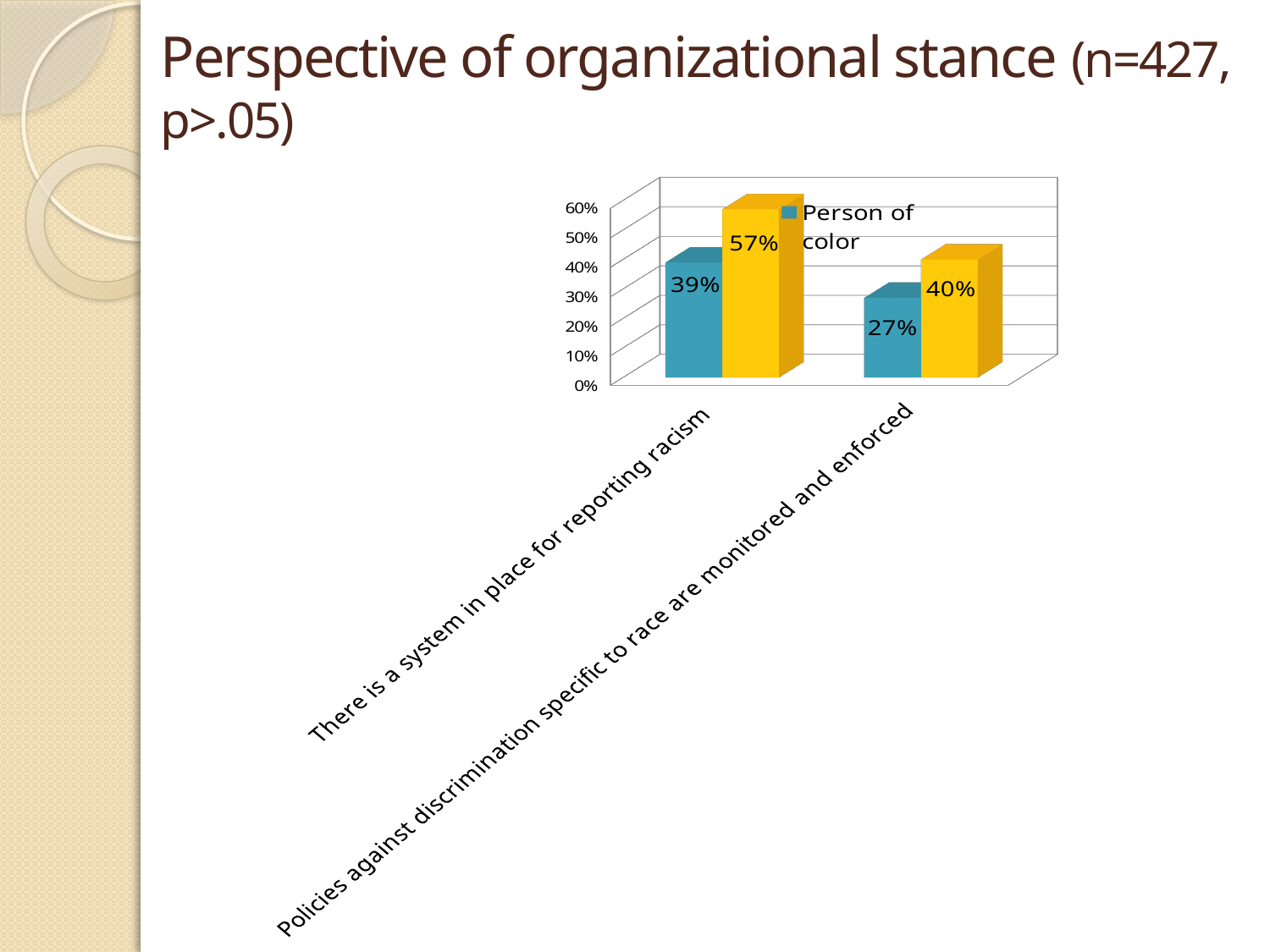
What is the value of the yellow bar for "There is a system in place for reporting racism"? 57% Which category has the higher Person of color value? There is a system in place for reporting racism What is the value for Person of color for "Policies against discrimination specific to race are monitored and enforced"? 27% How many categories are shown on the x axis? 2 Do the Person of color values rise or fall from the first category to the second? Fall For "There is a system in place for reporting racism", which is larger: the Person of color bar or the yellow bar? The yellow bar What is the value for Person of color for "There is a system in place for reporting racism"? 39% What is the difference between the yellow bar and the Person of color bar for "Policies against discrimination specific to race are monitored and enforced"? 13 percentage points What is the difference between the yellow bar and the Person of color bar for "There is a system in place for reporting racism"? 18 percentage points Which category has the lowest value shown on the chart? Policies against discrimination specific to race are monitored and enforced What kind of chart is shown on the slide? Bar chart What is the value of the yellow bar for "Policies against discrimination specific to race are monitored and enforced"? 40%